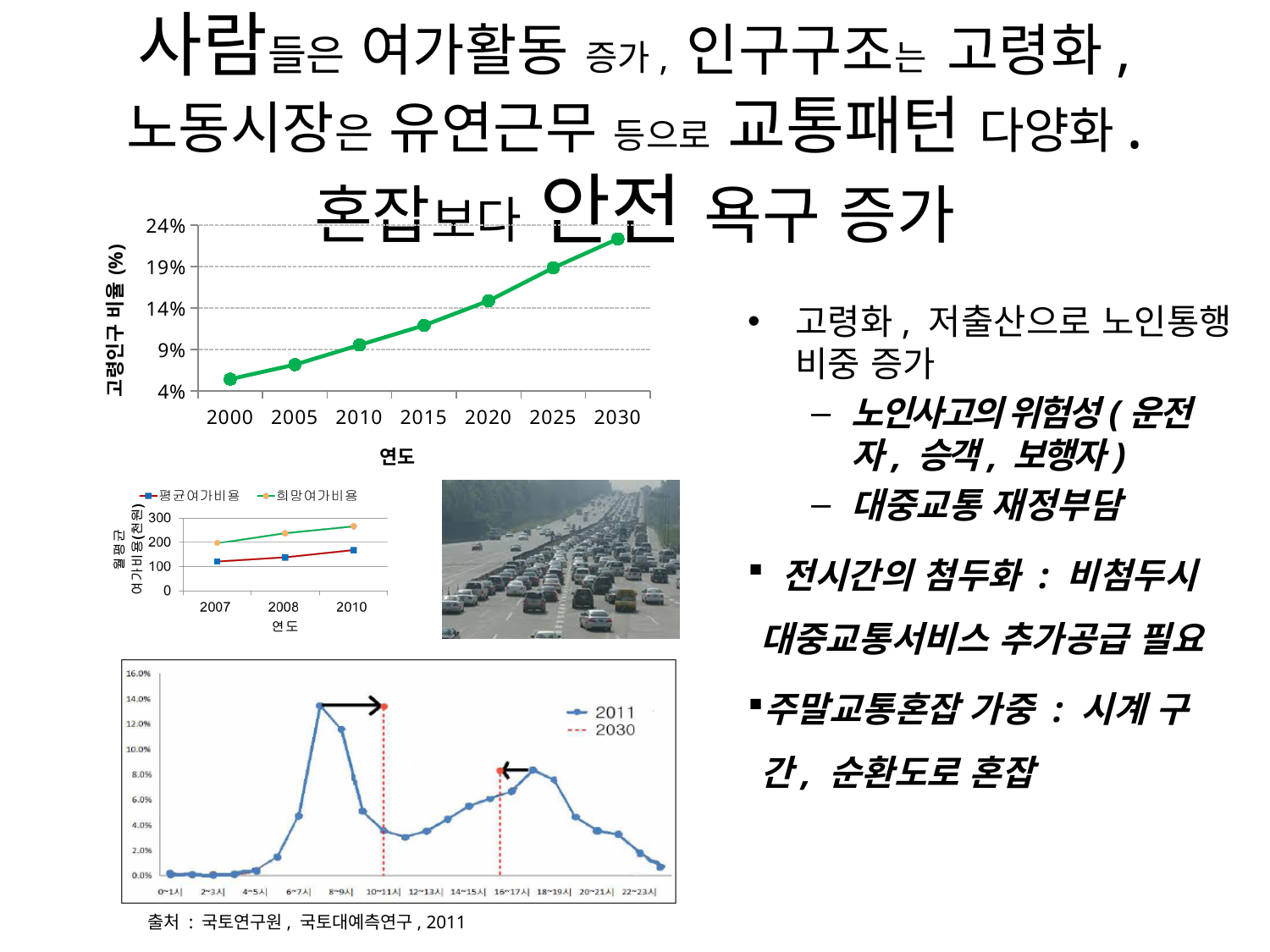
In the top-left chart of 고령인구 비율 (%), is the value for 2000 greater or less than 9%? less What kind of chart is the top-left chart showing 고령인구 비율 (%)? line chart What are the two series listed in the legend of the bottom chart of hourly traffic distribution? 2011 and 2030 In the top-left chart of 고령인구 비율 (%), how many years are plotted along the x axis? 7 How many series does the legend of the middle-left chart (월평균 여가비용) list? 2 In the middle-left chart (월평균 여가비용), which series is larger in 2010, 평균여가비용 or 희망여가비용? 희망여가비용 In the top-left chart of 고령인구 비율 (%), which year has the lowest value? 2000 In the middle-left chart (월평균 여가비용), how many years are shown on the x axis? 3 In the middle-left chart (월평균 여가비용), is the value of 희망여가비용 for 2010 greater or less than 200? greater In the top-left chart of 고령인구 비율 (%), do the values rise or fall from 2000 to 2030? rise In the top-left chart of 고령인구 비율 (%), which year has the highest value? 2030 In the top-left chart of 고령인구 비율 (%), is the value for 2020 greater or less than 14%? greater